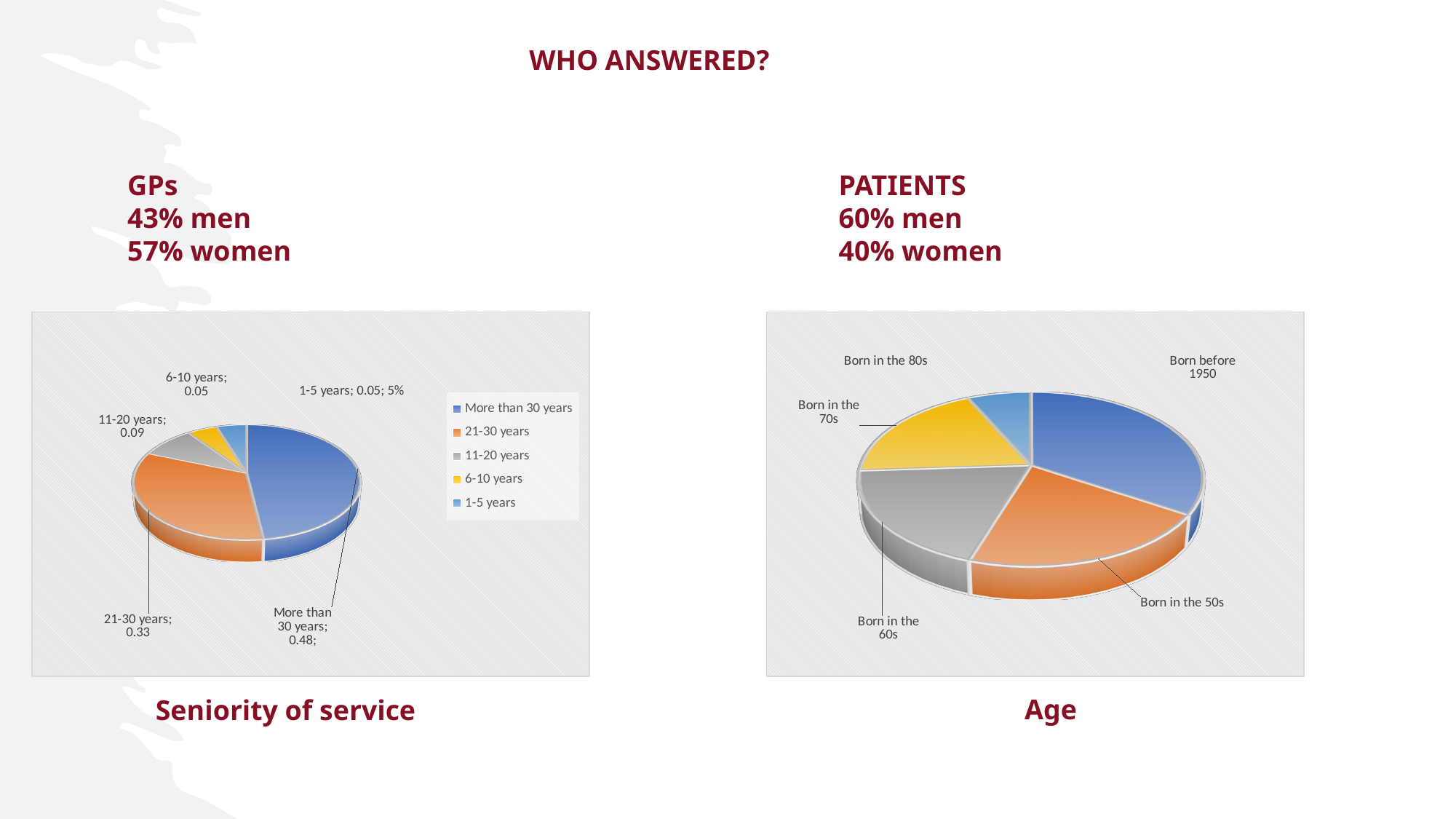
In the Age chart, which category has the smallest share? Born in the 80s In the Seniority of service chart, which colour represents 21-30 years? Orange In the Seniority of service chart, which category has the largest share? More than 30 years In the Seniority of service chart, what is the value for 21-30 years? 0.33 In the Seniority of service chart, what is the value for More than 30 years? 0.48 In the Age chart, which category has the largest share? Born before 1950 How many categories does the Age chart show? 5 What kind of chart is the Seniority of service chart? Pie chart How many categories does the Seniority of service chart show? 5 In the Seniority of service chart, which is larger: 11-20 years or 6-10 years? 11-20 years In the Seniority of service chart, what is the difference between the values for More than 30 years and 21-30 years? 0.15 In the Seniority of service chart, what is the value for 11-20 years? 0.09